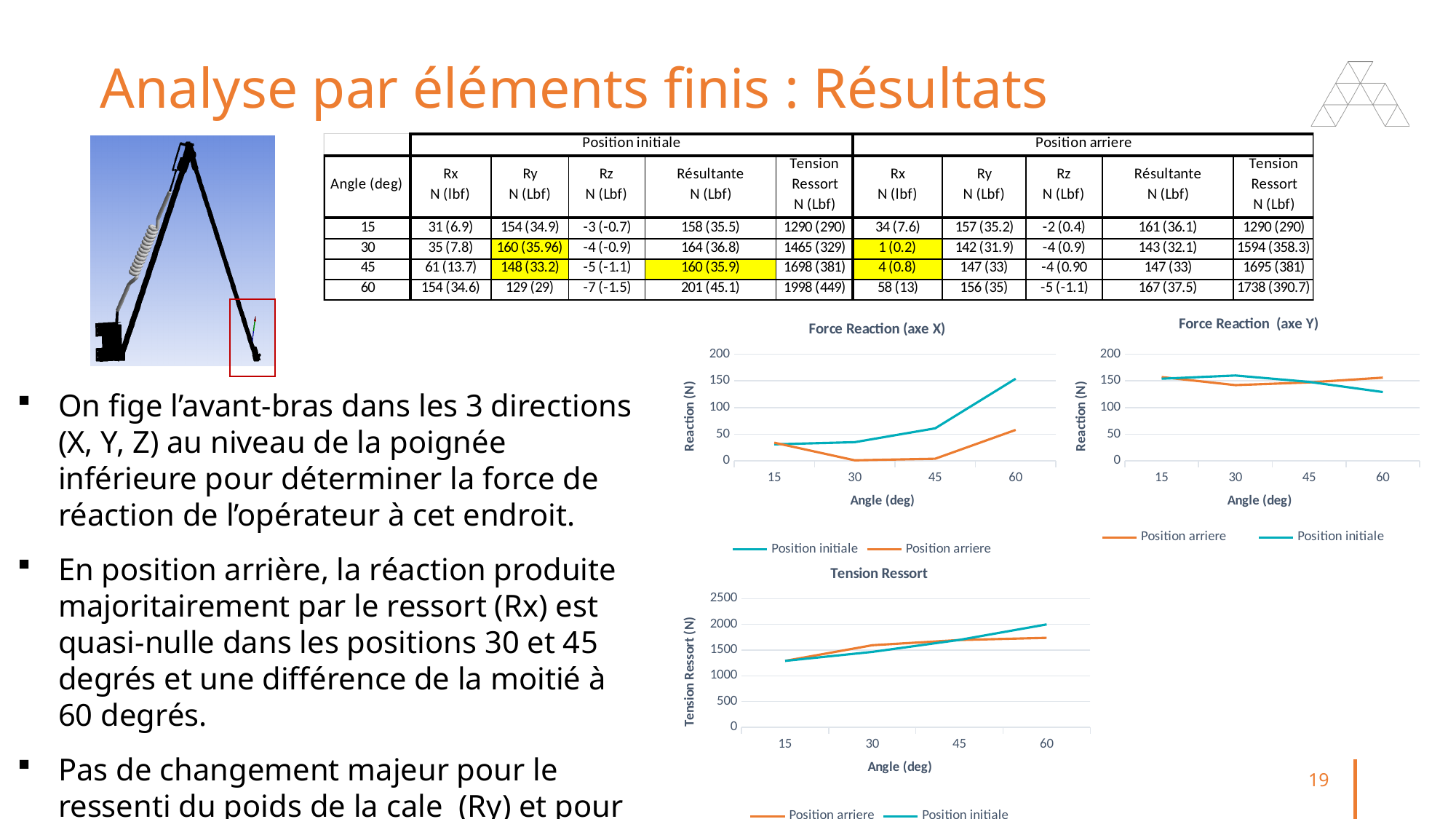
In the "Force Reaction (axe X)" chart, at which angle does the Position initiale series reach its highest value? 60 In the "Tension Ressort" chart, does the Position initiale series rise or fall from 15 to 60 degrees? rises What kind of chart is the "Force Reaction (axe X)" chart? line chart How many series does the legend of the "Force Reaction (axe X)" chart list? 2 In the "Force Reaction (axe X)" chart, which series has the larger value at 60 degrees? Position initiale In the "Force Reaction (axe X)" chart, is the value for Position initiale at 60 degrees greater or less than 100? greater In the "Tension Ressort" chart, is the value for Position initiale at 60 degrees greater or less than 1500? greater How many angle values are plotted along the x axis of the "Tension Ressort" chart? 4 In the "Force Reaction (axe Y)" chart, is the value for Position initiale at 60 degrees greater or less than 150? less What is the y-axis title of the "Tension Ressort" chart? Tension Ressort (N) In the "Tension Ressort" chart, which series has the larger value at 30 degrees? Position arriere